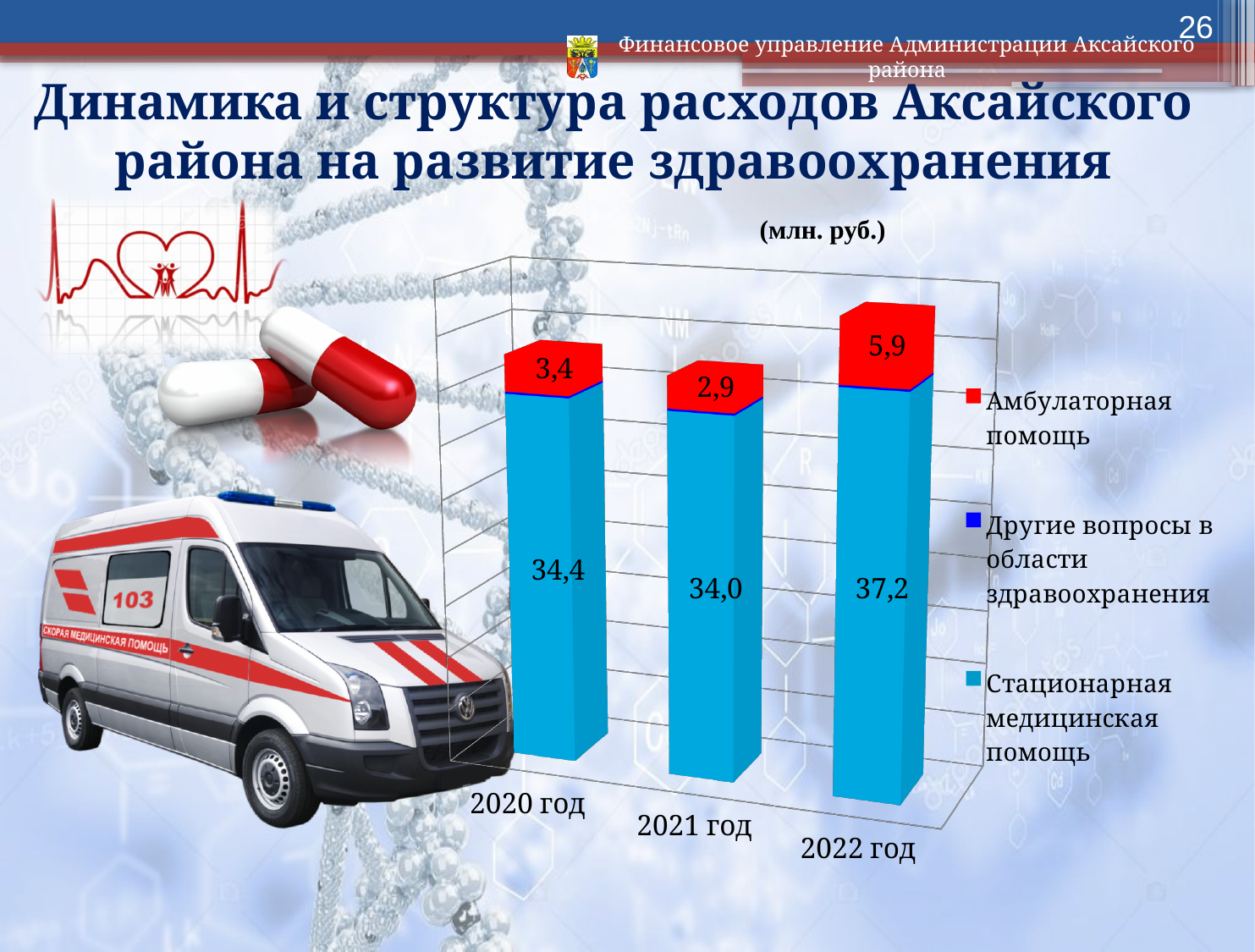
What kind of chart is shown on the slide? Stacked bar chart What is the difference between the Стационарная медицинская помощь values for 2022 год and 2020 год? 2,8 How many years are shown on the x axis of the chart? 3 What is the value for Амбулаторная помощь in 2021 год? 2,9 What is the value for Стационарная медицинская помощь in 2022 год? 37,2 In which year is the value for Амбулаторная помощь the highest? 2022 год In which year is the value for Стационарная медицинская помощь the lowest? 2021 год What is the value for Стационарная медицинская помощь in 2021 год? 34,0 What is the value for Амбулаторная помощь in 2020 год? 3,4 How many series does the chart legend list? 3 What is the difference between the Амбулаторная помощь values for 2022 год and 2021 год? 3,0 Which is larger: the Стационарная медицинская помощь value for 2020 год or for 2021 год? 2020 год